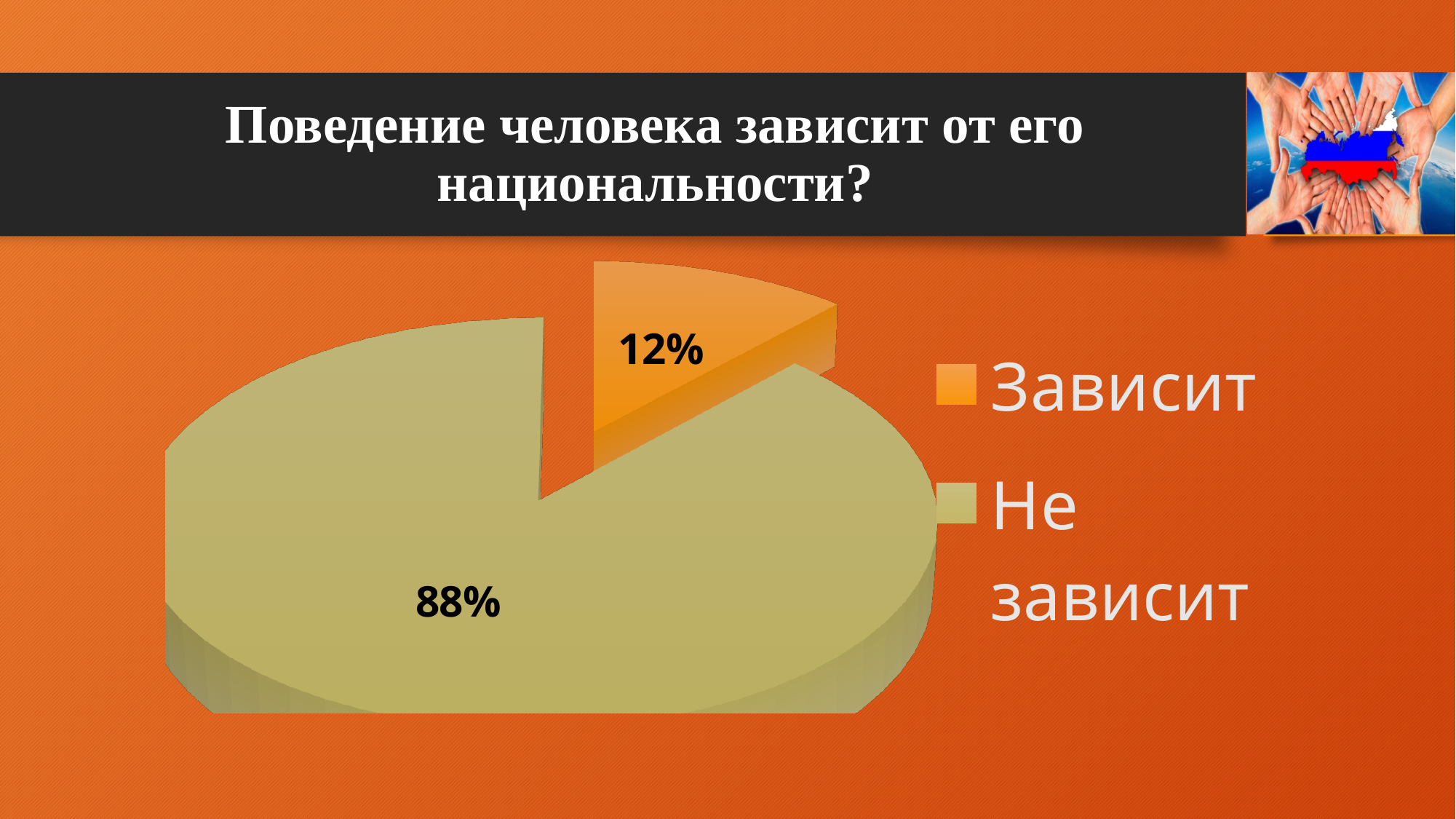
What colour is the "Зависит" slice in the pie chart? orange What share of the pie does the "Зависит" slice represent? 12% Which category has the largest slice of the pie? Не зависит What share of the pie does the "Не зависит" slice represent? 88% How many slices does the pie chart have? 2 What is the title of the chart? Поведение человека зависит от его национальности? Which category has the smallest slice of the pie? Зависит What kind of chart is shown on the slide? pie chart What is the difference in percentage points between the "Не зависит" and "Зависит" slices? 76 Which is larger, the "Зависит" slice or the "Не зависит" slice? Не зависит How many entries does the legend list? 2